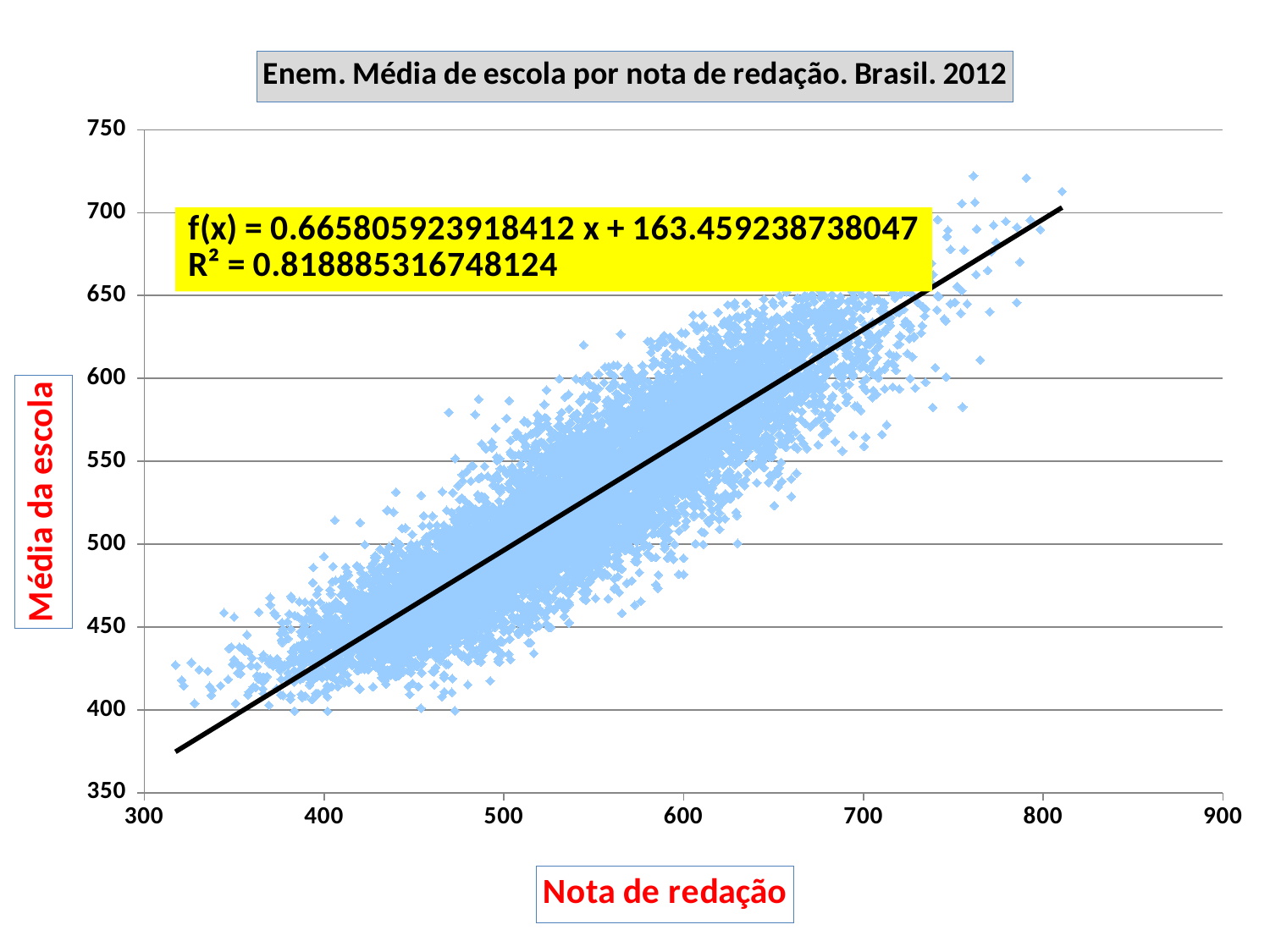
Is the R² value of the trendline greater or less than 0.8? greater What is the R² value shown for the trendline? 0.818885316748124 What is the intercept (constant term) in the trendline equation shown on the chart? 163.459238738047 What is the highest tick value shown on the horizontal axis? 900 Do the values of Média da escola rise or fall as Nota de redação increases along the x axis? Rise What is the highest tick value shown on the vertical axis? 750 What kind of chart is shown on the slide? Scatter plot What is the title of the chart? Enem. Média de escola por nota de redação. Brasil. 2012 Is the slope of the trendline greater or less than 1? less What is the slope (coefficient of x) in the trendline equation shown on the chart? 0.665805923918412 What is the label of the vertical axis? Média da escola